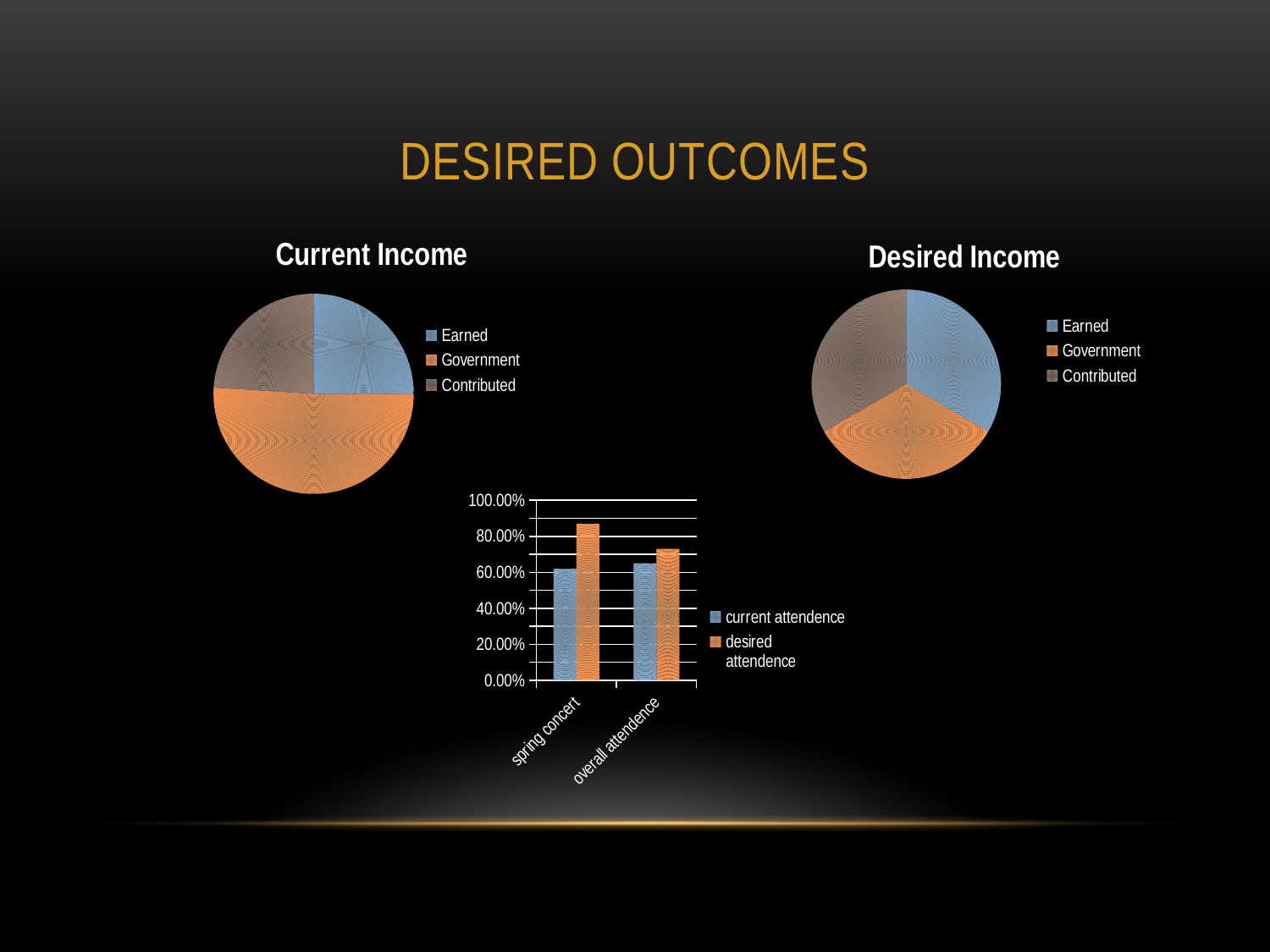
How many slices does the "Current Income" pie chart have? 3 In the "Current Income" pie chart, which colour represents Government? orange In the "Current Income" pie chart, which category has the largest slice? Government In the bottom bar chart, is the value for desired attendence at overall attendence greater or less than 80.00%? less In the bottom bar chart, how many categories are shown on the x axis? 2 In the bottom bar chart, is the value for desired attendence at spring concert greater or less than 80.00%? greater What kind of chart is the "Current Income" chart? pie chart In the bottom bar chart, which bar is the tallest overall? desired attendence for spring concert In the bottom bar chart, how many series does the legend list? 2 How many entries does the legend of the "Desired Income" pie chart list? 3 In the bottom bar chart, for spring concert, which is larger: current attendence or desired attendence? desired attendence What kind of chart is the chart at the bottom of the slide with the attendance series? bar chart